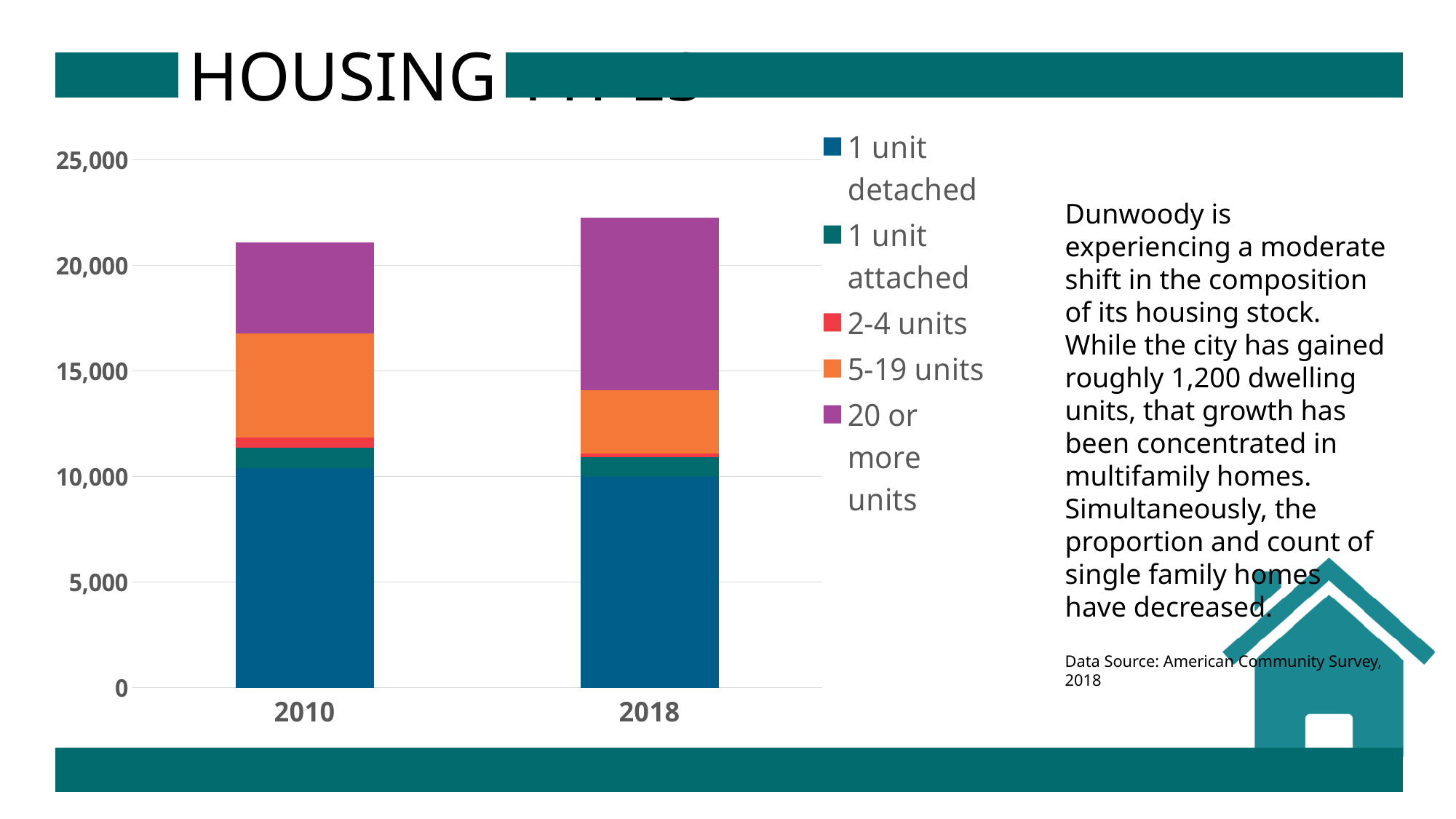
Which housing type is the smallest segment in the 2010 bar? 2-4 units How many series does the legend list? 5 Is the '1 unit detached' segment for 2010 greater or less than 10,000? greater What colour represents '20 or more units' in the legend? Purple What kind of chart is shown on the slide? Stacked bar chart Which housing type is the largest segment in the 2018 bar? 1 unit detached Which year has the larger '5-19 units' segment, 2010 or 2018? 2010 Is the total height of the 2018 bar greater or less than 25,000? less Which year has the taller total stacked bar, 2010 or 2018? 2018 How many years (categories) are plotted on the x axis? 2 Is the total height of the 2010 bar greater or less than 20,000? greater Which year has the larger '20 or more units' segment, 2010 or 2018? 2018